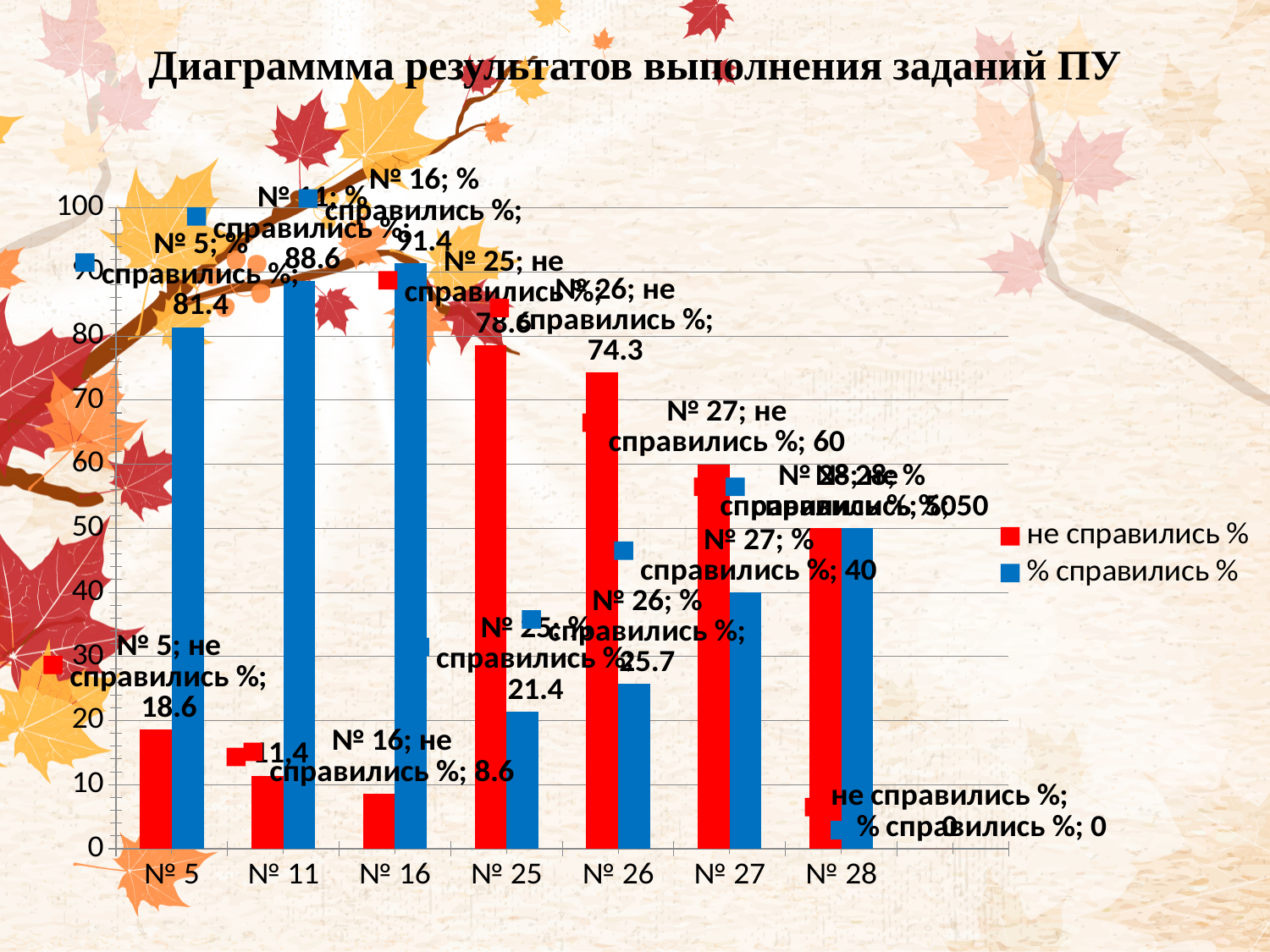
What is the value of "% справились %" for № 27? 40 What is the title of the chart? Диаграммма результатов выполнения заданий ПУ What kind of chart is shown on the slide? bar chart What is the value of "% справились %" for № 5? 81.4 What is the value of "не справились %" for № 26? 74.3 How many series does the legend list? 2 What is the difference between the "не справились %" values for № 25 and № 26? 4.3 Which task has the highest "% справились %" value? № 16 How many labelled task categories are shown on the x axis? 7 Which is larger for № 25: "не справились %" or "% справились %"? не справились % Which task has the lowest "не справились %" value? № 16 What is the value of "не справились %" for № 16? 8.6